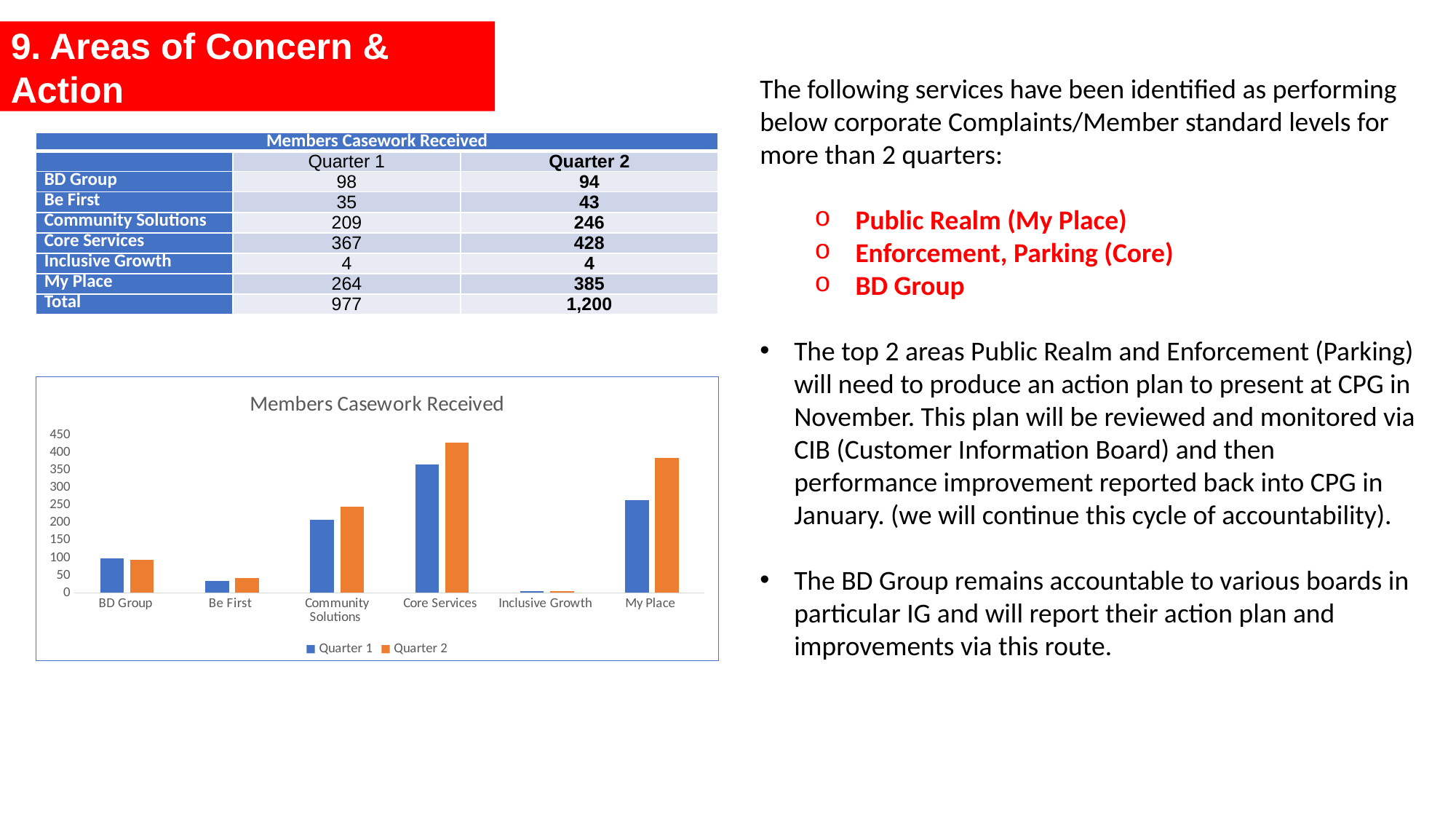
How many series does the legend of the Members Casework Received chart list? 2 What is the difference between the Quarter 2 and Quarter 1 values for Core Services in Members Casework Received? 61 What is the Quarter 1 value for Community Solutions in Members Casework Received? 209 What is the title of the chart on the slide? Members Casework Received In the Members Casework Received chart, which is larger for BD Group: Quarter 1 or Quarter 2? Quarter 1 Which category has the lowest Quarter 1 value in the Members Casework Received chart? Inclusive Growth Is the Quarter 1 value for My Place greater or less than 250 in the Members Casework Received chart? greater Is the Quarter 2 value for Be First greater or less than 50 in the Members Casework Received chart? less What is the Quarter 2 value for My Place in Members Casework Received? 385 How many categories are shown on the x axis of the Members Casework Received chart? 6 Which category has the highest Quarter 2 value in the Members Casework Received chart? Core Services What type of chart is shown on the slide? bar chart